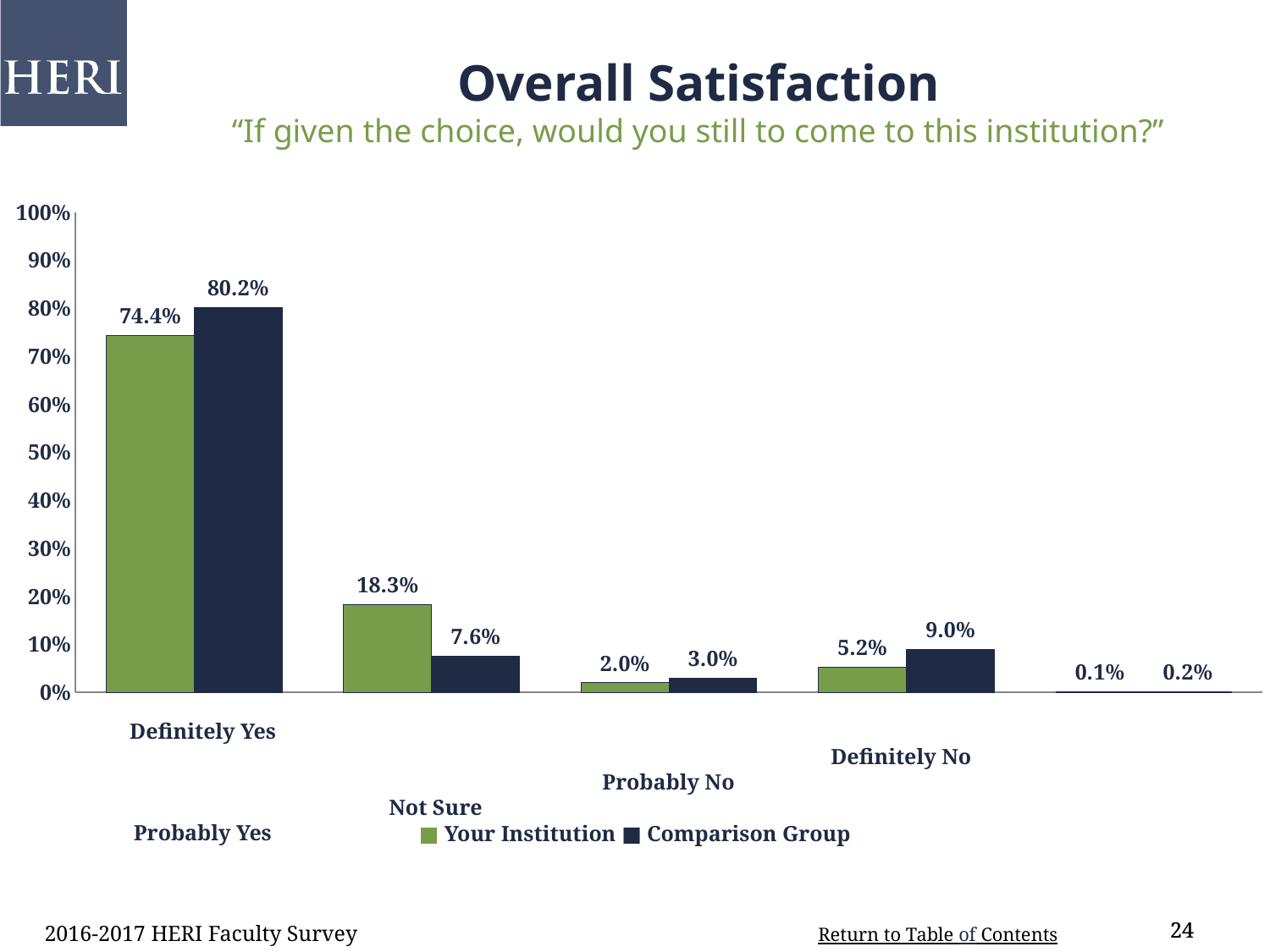
What is the value for the Comparison Group in the Definitely Yes category? 80.2% In the Definitely Yes category, which series has the larger value, Your Institution or the Comparison Group? Comparison Group Do the Comparison Group values generally rise or fall from left to right across the categories? fall What kind of chart is shown on the slide? bar chart How many category groups of bars are shown in the chart? 5 What is the lowest value shown for Your Institution? 0.1% Which series is shown in green in the legend? Your Institution Is the value for Your Institution in the Definitely Yes category greater or less than 70%? greater What is the value for Your Institution in the Definitely Yes category? 74.4% How many series does the legend list? 2 What is the difference between the Comparison Group and Your Institution values in the Definitely Yes category? 5.8 percentage points Which category has the highest value for Your Institution? Definitely Yes